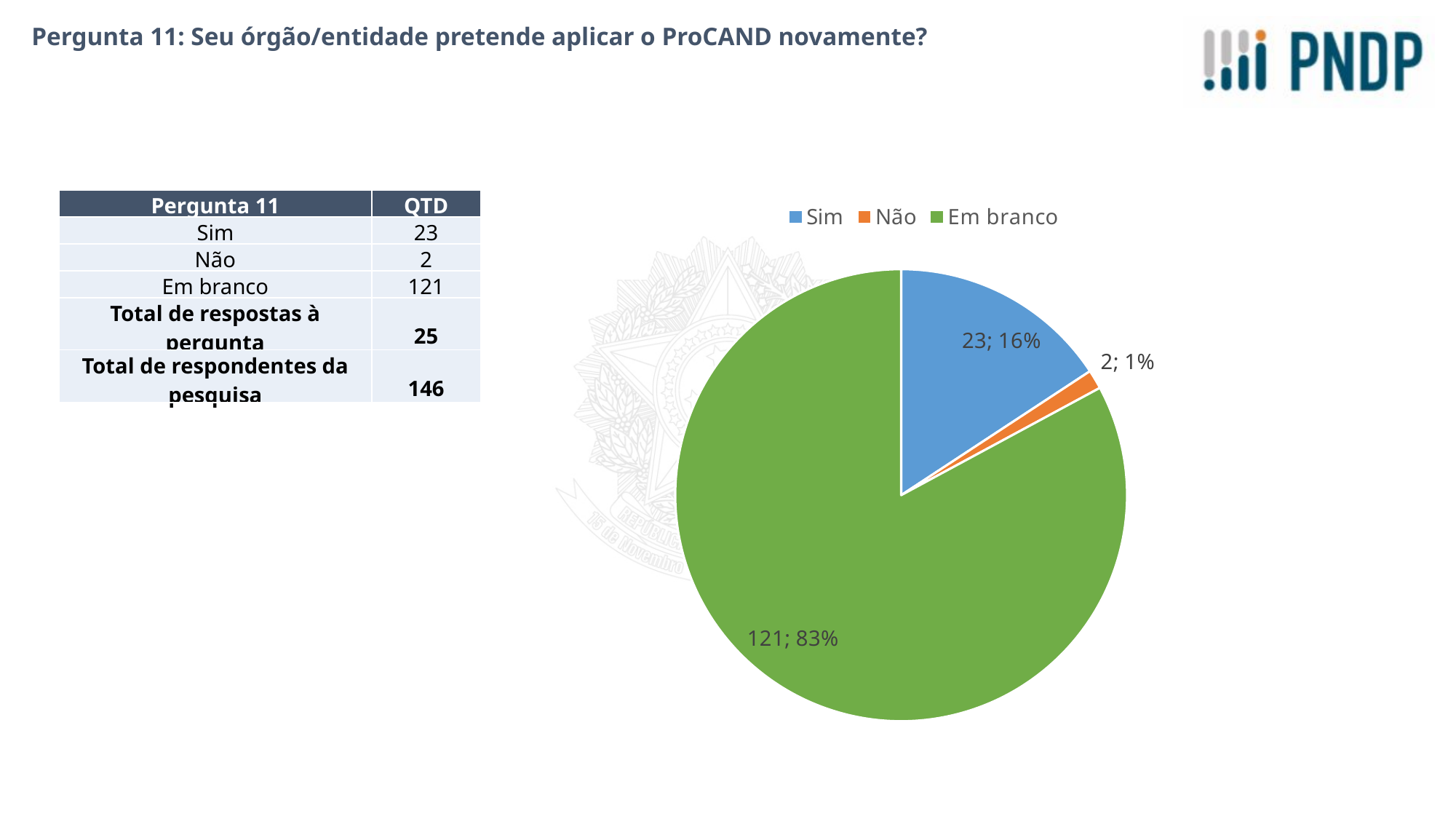
How many slices does the pie chart have? 3 What percentage share does the 'Em branco' slice have in the pie chart? 83% What kind of chart is shown on the slide? pie chart Which category has the smallest slice in the pie chart? Não What is the value shown for the 'Sim' slice of the pie chart? 23 Which colour represents 'Não' in the pie chart? orange What is the value shown for the 'Não' slice of the pie chart? 2 What percentage share does the 'Sim' slice have in the pie chart? 16% What is the value shown for the 'Em branco' slice of the pie chart? 121 What is the difference between the 'Em branco' value and the 'Sim' value in the pie chart? 98 How many entries does the legend of the pie chart list? 3 Which category has the largest slice in the pie chart? Em branco